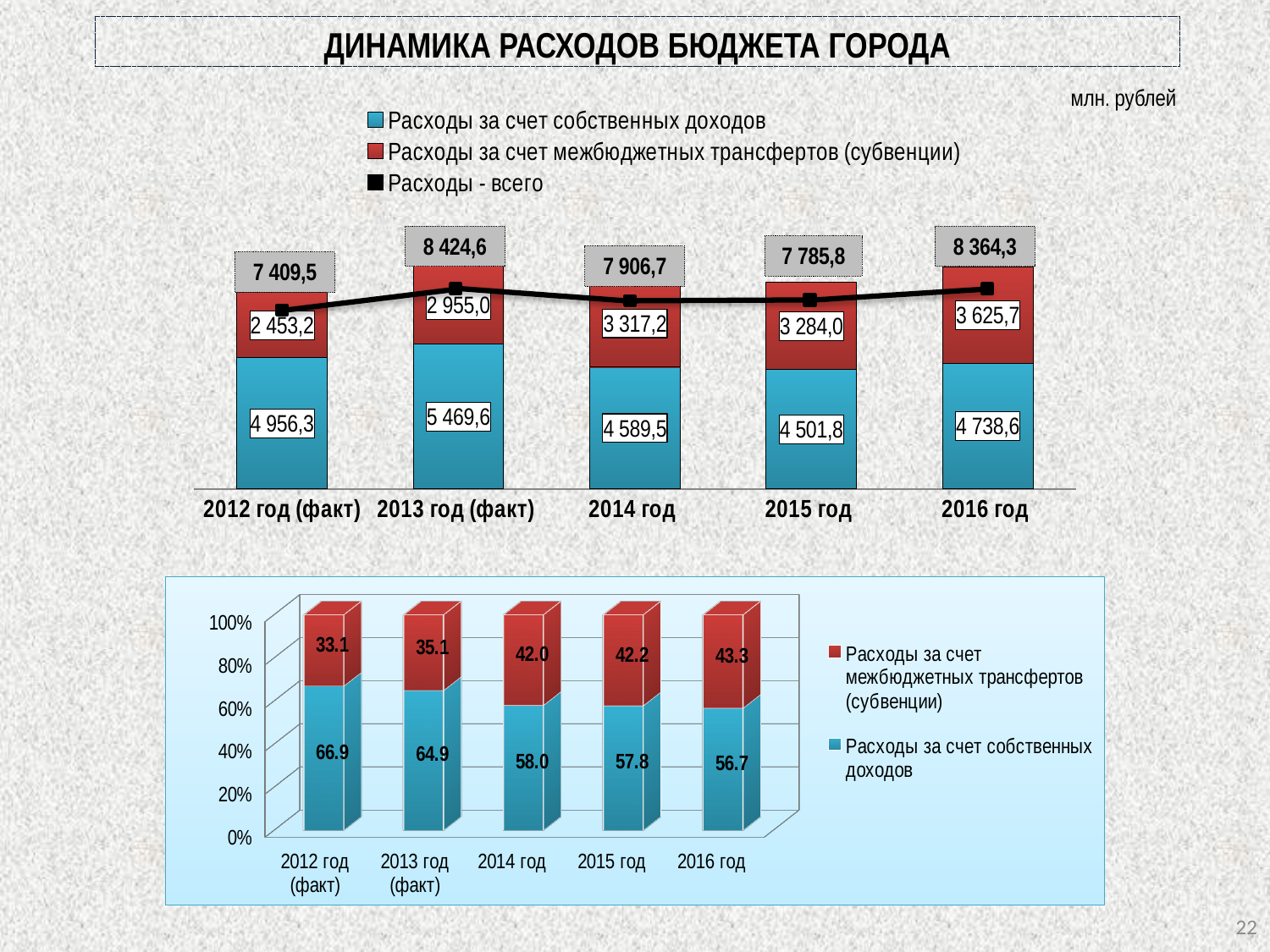
In the top chart, what is the value of 'Расходы - всего' for 2013 год (факт)? 8 424,6 In the top chart, what is the difference between 'Расходы за счет собственных доходов' in 2013 год (факт) and in 2012 год (факт)? 513,3 In the bottom chart, does the share of 'Расходы за счет межбюджетных трансфертов (субвенции)' rise or fall from 2012 год (факт) to 2016 год? rise How many years are shown on the x axis of the bottom chart? 5 In the top chart, which is larger: 'Расходы за счет межбюджетных трансфертов (субвенции)' in 2014 год or in 2015 год? 2014 год In the top chart, what is the value of 'Расходы за счет межбюджетных трансфертов (субвенции)' for 2016 год? 3 625,7 What unit is stated for the values in the top chart? млн. рублей In the bottom chart, what is the share of 'Расходы за счет собственных доходов' for 2016 год? 56.7 In the top chart, which year has the highest value of 'Расходы за счет собственных доходов'? 2013 год (факт) In the top chart, which year has the lowest value of 'Расходы - всего'? 2012 год (факт) How many series does the legend of the top chart list? 3 In the bottom chart, which year has the lowest share of 'Расходы за счет собственных доходов'? 2016 год